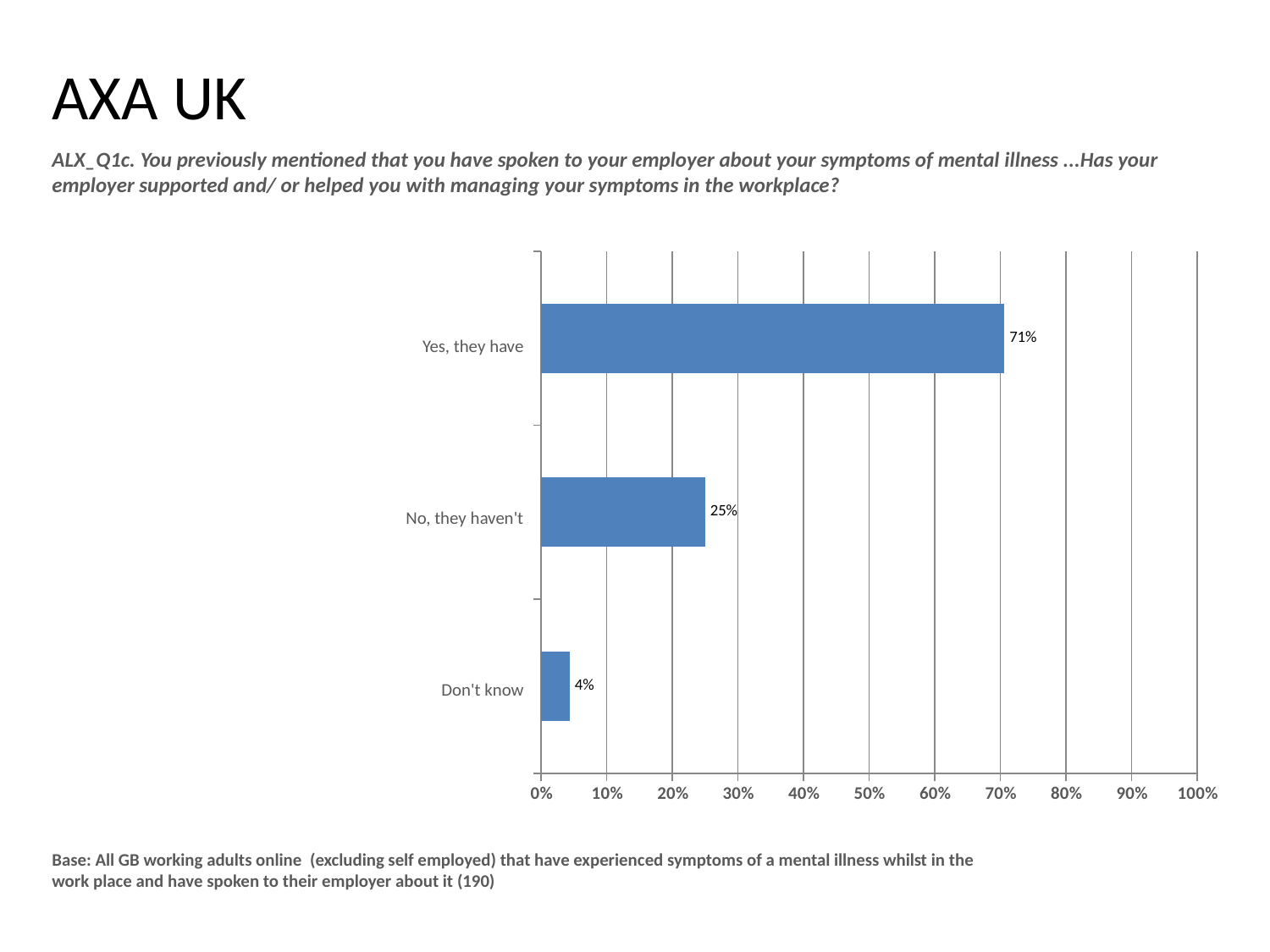
What kind of chart is shown on the slide? Bar chart How many response categories are shown in the chart? 3 Which response category has the lowest value? Don't know What is the base size shown for the chart? 190 What percentage of respondents answered "Don't know"? 4% Which is larger, the value for "No, they haven't" or the value for "Don't know"? No, they haven't Which response category has the highest value? Yes, they have What is the difference between the "No, they haven't" and "Don't know" values? 21% What percentage of respondents answered "No, they haven't"? 25% Is the value for "Yes, they have" greater or less than 60%? greater What percentage of respondents answered "Yes, they have"? 71% What is the difference between the "Yes, they have" and "No, they haven't" values? 46%